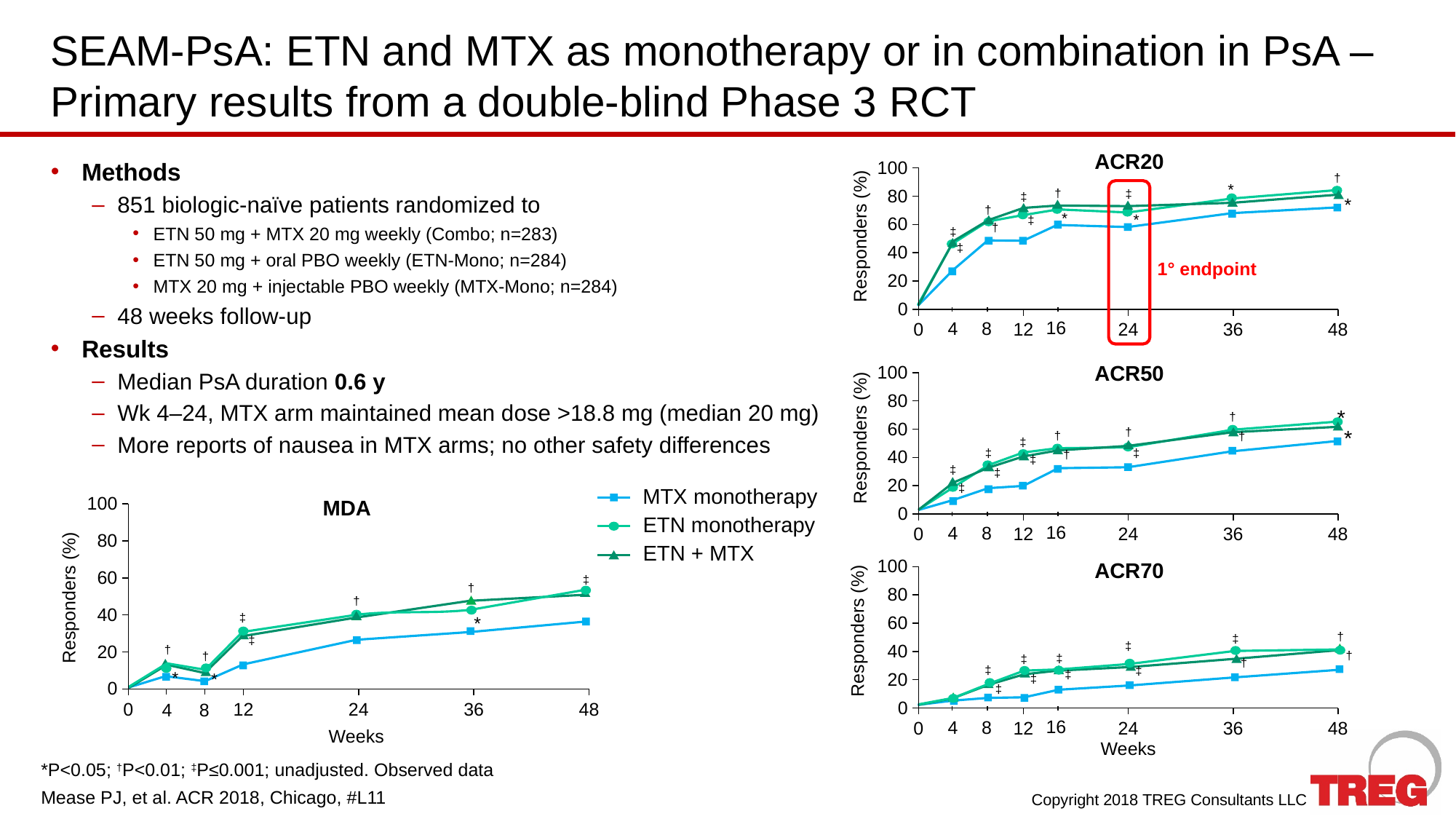
In the MDA chart, which series has the lowest value at week 48? MTX monotherapy In the ACR20 chart, which week is highlighted as the primary (1°) endpoint? 24 How many week labels are shown on the x axis of the MDA chart? 7 In the ACR50 chart, is the value for MTX monotherapy at week 48 greater or less than 60? less In the ACR20 chart, is the value for MTX monotherapy at week 48 greater or less than 60? greater What are the three series named in the legend? MTX monotherapy, ETN monotherapy, ETN + MTX In the ACR70 chart, which is larger at week 48: MTX monotherapy or ETN monotherapy? ETN monotherapy In the ACR20 chart, does the MTX monotherapy line rise or fall from week 0 to week 48? rise What kind of chart is the MDA chart? line chart In the MDA chart, is the value for ETN monotherapy at week 48 greater or less than 40? greater How many series does the legend list for the charts? 3 In the ACR20 chart, which series has the lowest value at week 4? MTX monotherapy